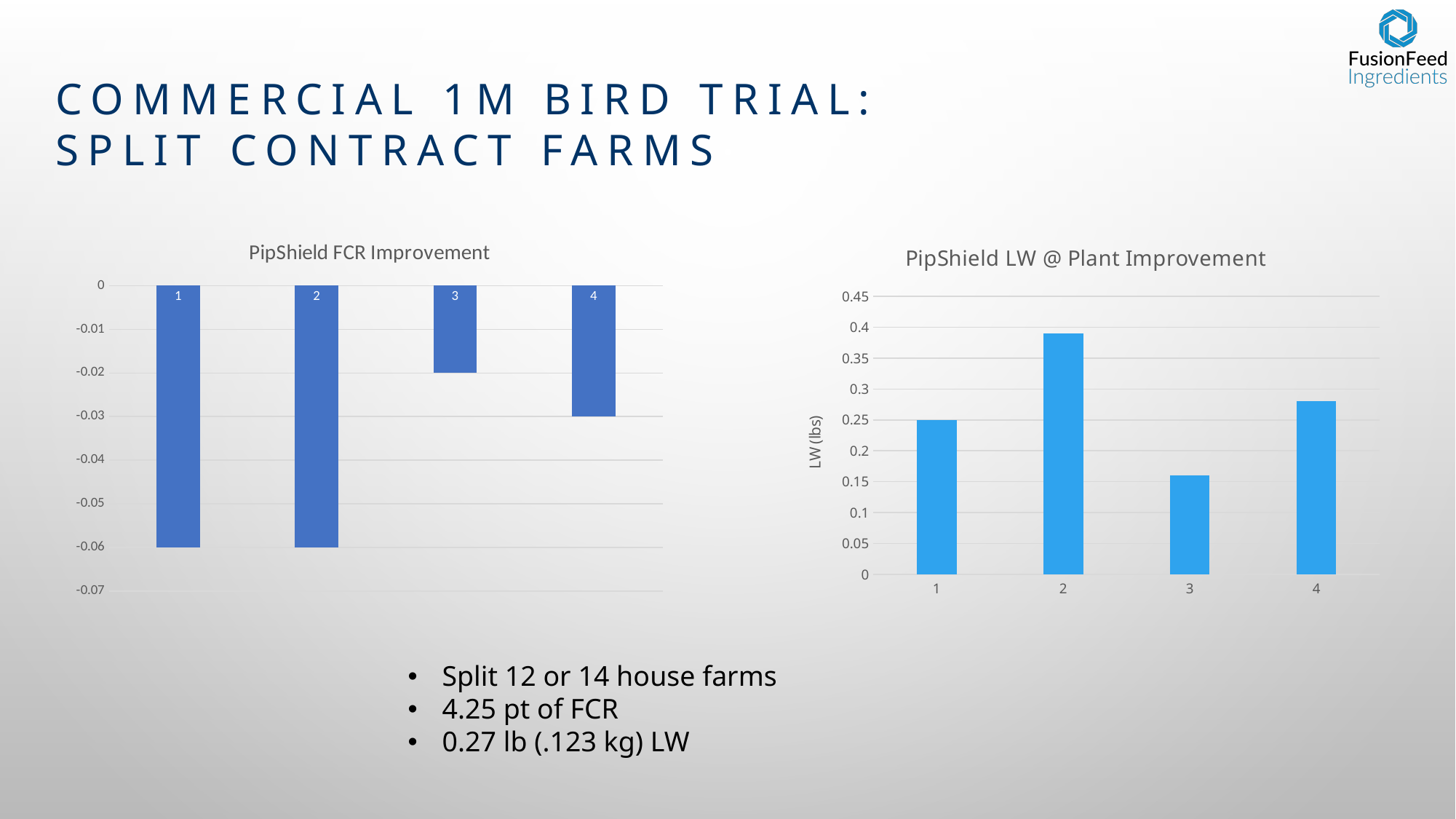
How many bars are plotted in the PipShield FCR Improvement chart? 4 In the PipShield LW @ Plant Improvement chart, which category has the lowest value? 3 In the PipShield LW @ Plant Improvement chart, which category has the highest value? 2 In the PipShield LW @ Plant Improvement chart, which is larger, the value for category 4 or the value for category 1? 4 In the PipShield LW @ Plant Improvement chart, is the value for category 2 greater or less than 0.35? greater In the PipShield FCR Improvement chart, what is the value for category 4? -0.03 In the PipShield LW @ Plant Improvement chart, what is the value for category 1? 0.25 In the PipShield FCR Improvement chart, what is the difference between the values for category 1 and category 3? 0.04 In the PipShield FCR Improvement chart, what is the value for category 3? -0.02 In the PipShield FCR Improvement chart, what is the value for category 1? -0.06 What kind of chart is the PipShield FCR Improvement chart on the left? bar chart What is the y-axis label of the PipShield LW @ Plant Improvement chart? LW (lbs)